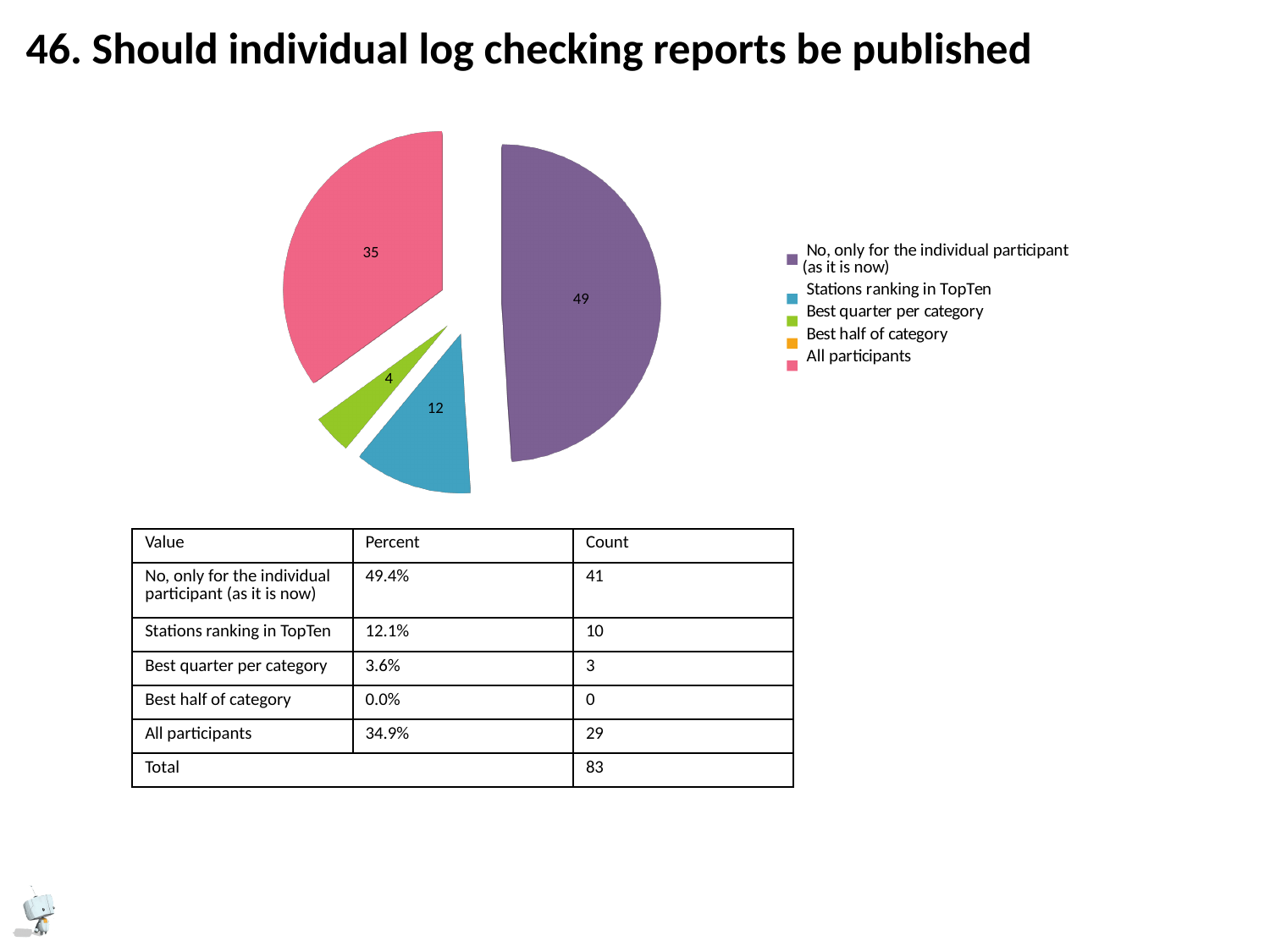
What is the data label on the pie slice for "All participants"? 35 What is the title of the slide containing the pie chart? 46. Should individual log checking reports be published What colour is the slice for "All participants"? pink What is the data label on the pie slice for "Stations ranking in TopTen"? 12 Which category has the largest slice of the pie? No, only for the individual participant (as it is now) Which category with a visible slice has the smallest slice of the pie? Best quarter per category What is the data label on the pie slice for "Best quarter per category"? 4 How many entries does the pie chart's legend list? 5 What is the data label on the pie slice for "No, only for the individual participant (as it is now)"? 49 Which slice is larger: "Stations ranking in TopTen" or "Best quarter per category"? Stations ranking in TopTen What type of chart is shown on the slide? pie chart What is the difference between the data labels for "No, only for the individual participant (as it is now)" and "All participants"? 14